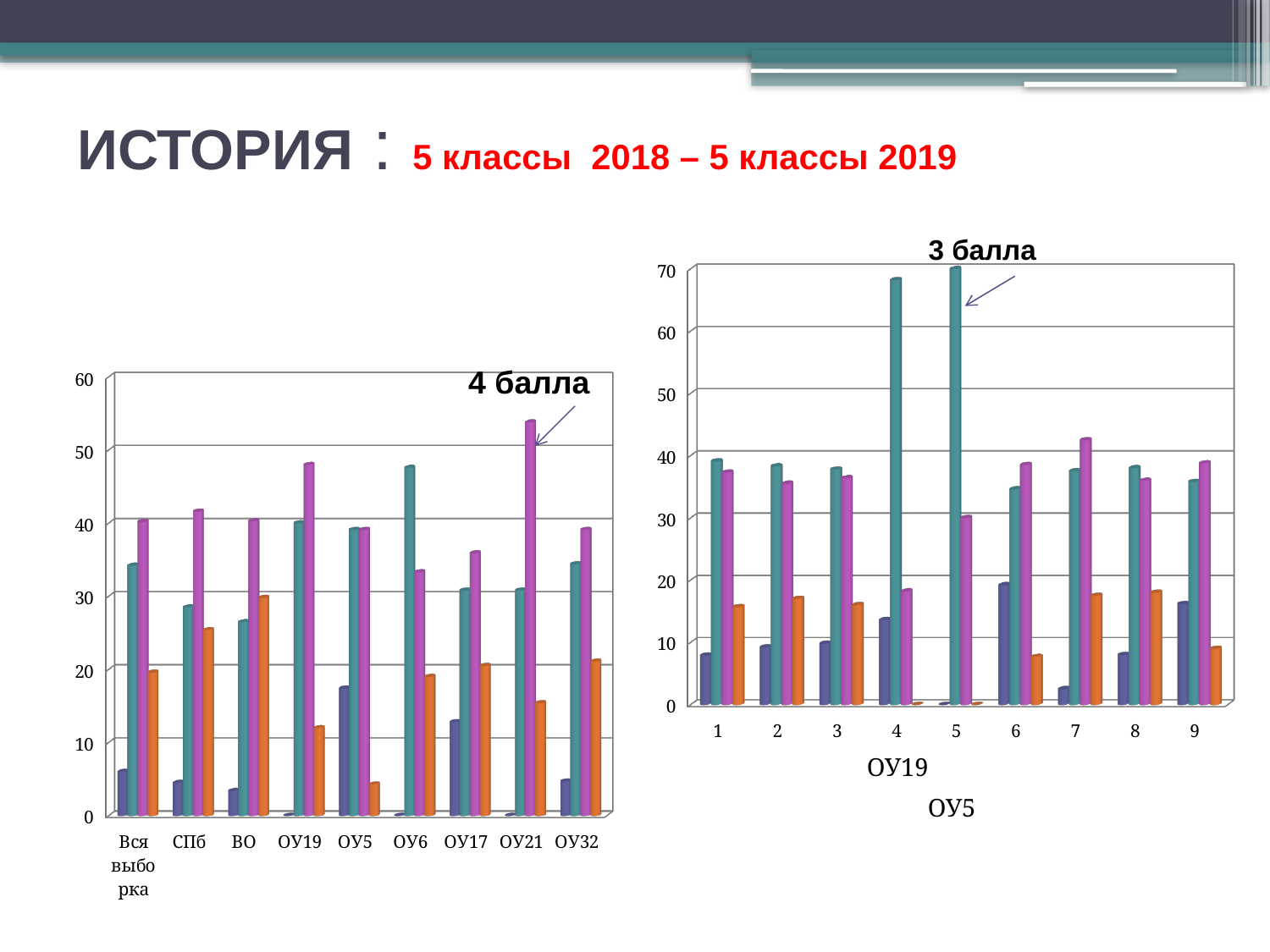
In the right chart, is the magenta bar for category 7 greater or less than 40? greater What kind of chart is the right chart on the slide? bar chart In the left chart, is the magenta bar for ОУ21 greater or less than 50? greater How many categories are shown on the x axis of the left chart? 9 How many categories are shown on the x axis of the right chart? 9 What kind of chart is the left chart on the slide? bar chart In the left chart, is the orange bar for ОУ5 greater or less than 10? less What annotation text is shown on the right chart? 3 балла In the left chart, which category has the tallest magenta bar? ОУ21 What annotation text is shown on the left chart? 4 балла In the right chart, is the teal bar for category 4 larger or smaller than the teal bar for category 1? larger